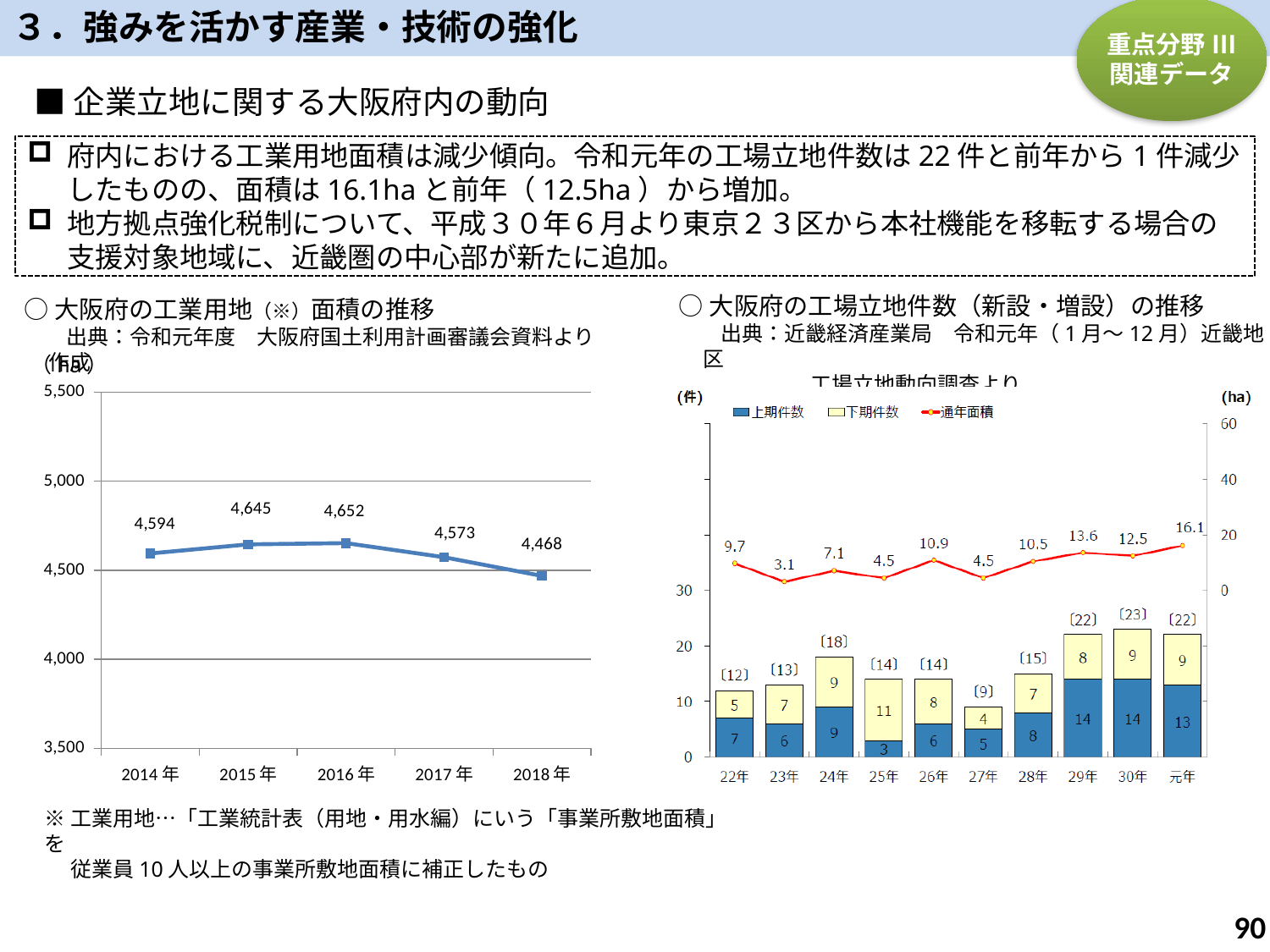
What kind of chart is the left chart (大阪府の工業用地面積の推移)? line chart In the right chart (大阪府の工場立地件数の推移), what is the 上期件数 value for 29年? 14 In the right chart (大阪府の工場立地件数の推移), is the 下期件数 value for 25年 larger or smaller than the 下期件数 value for 27年? larger In the right chart (大阪府の工場立地件数の推移), which year has the lowest 通年面積 value? 23年 In the left chart (大阪府の工業用地面積の推移), what is the difference between the 2014年 value and the 2018年 value? 126 In the left chart (大阪府の工業用地面積の推移), what is the value for 2016年? 4,652 In the left chart (大阪府の工業用地面積の推移), which year has the highest value? 2016年 In the right chart (大阪府の工場立地件数の推移), how many series does the legend list? 3 In the right chart (大阪府の工場立地件数の推移), what is the total number of cases for 30年 (上期件数 plus 下期件数)? 23 In the left chart (大阪府の工業用地面積の推移), how many years are plotted? 5 In the right chart (大阪府の工場立地件数の推移), what is the 通年面積 value for 元年? 16.1 In the left chart (大阪府の工業用地面積の推移), which year has the lowest value? 2018年